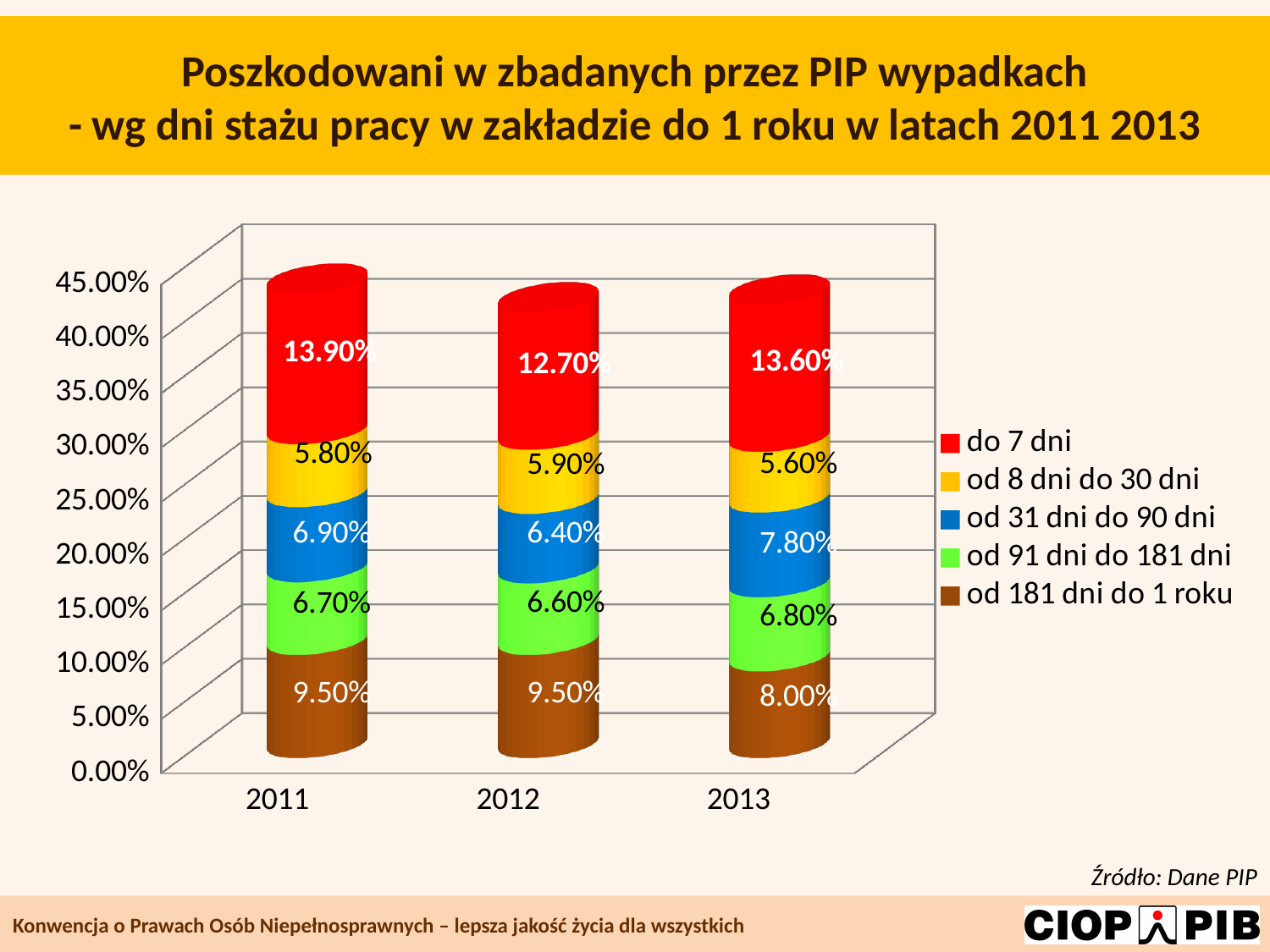
What is the value for "od 181 dni do 1 roku" in 2012? 9.50% In which year is the value for "od 31 dni do 90 dni" the highest? 2013 How many series does the legend list? 5 What is the value for "od 31 dni do 90 dni" in 2013? 7.80% What is the difference between the "od 181 dni do 1 roku" values for 2011 and 2013? 1.50% What kind of chart is shown on the slide? Stacked bar chart Which is larger: the "od 8 dni do 30 dni" value in 2012 or in 2013? 2012 What is the total of the stacked bar for 2011? 42.80% What is the total of the stacked bar for 2013? 41.80% How many years are shown on the x axis? 3 What is the value for "do 7 dni" in 2011? 13.90% In which year is the value for "do 7 dni" the lowest? 2012